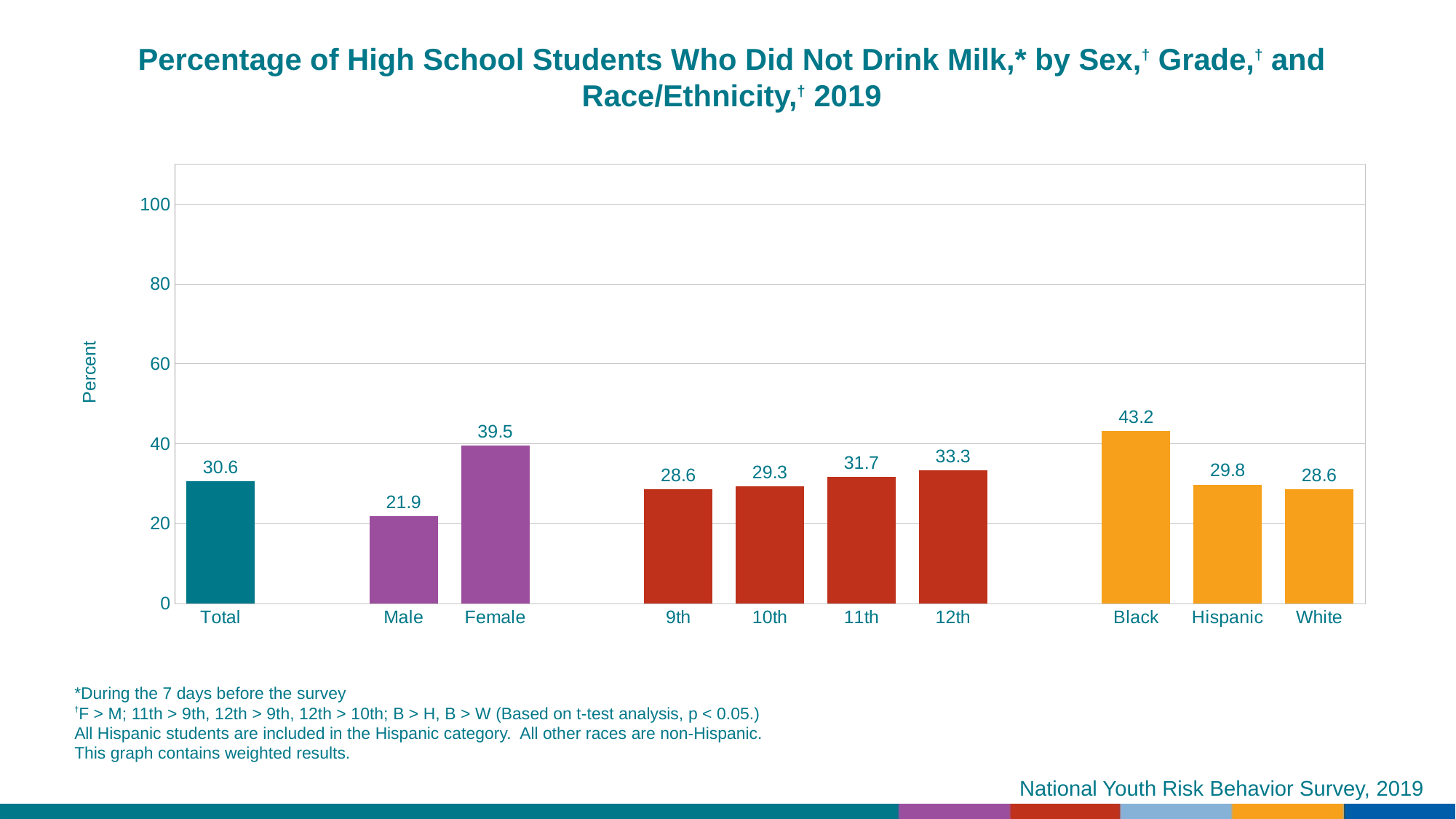
Do the values rise or fall from 9th grade to 12th grade? rise What is the difference between the Female and Male values? 17.6 Which category has the highest value? Black Which category has the lowest value? Male What is the value for Female? 39.5 What is the value for 11th grade? 31.7 What is the label on the y axis? Percent How many categories are shown on the x axis? 10 What kind of chart is this? bar chart Is the value for Black greater or less than 40? greater What is the value for Total? 30.6 Which is larger, the value for 12th grade or the value for 9th grade? 12th